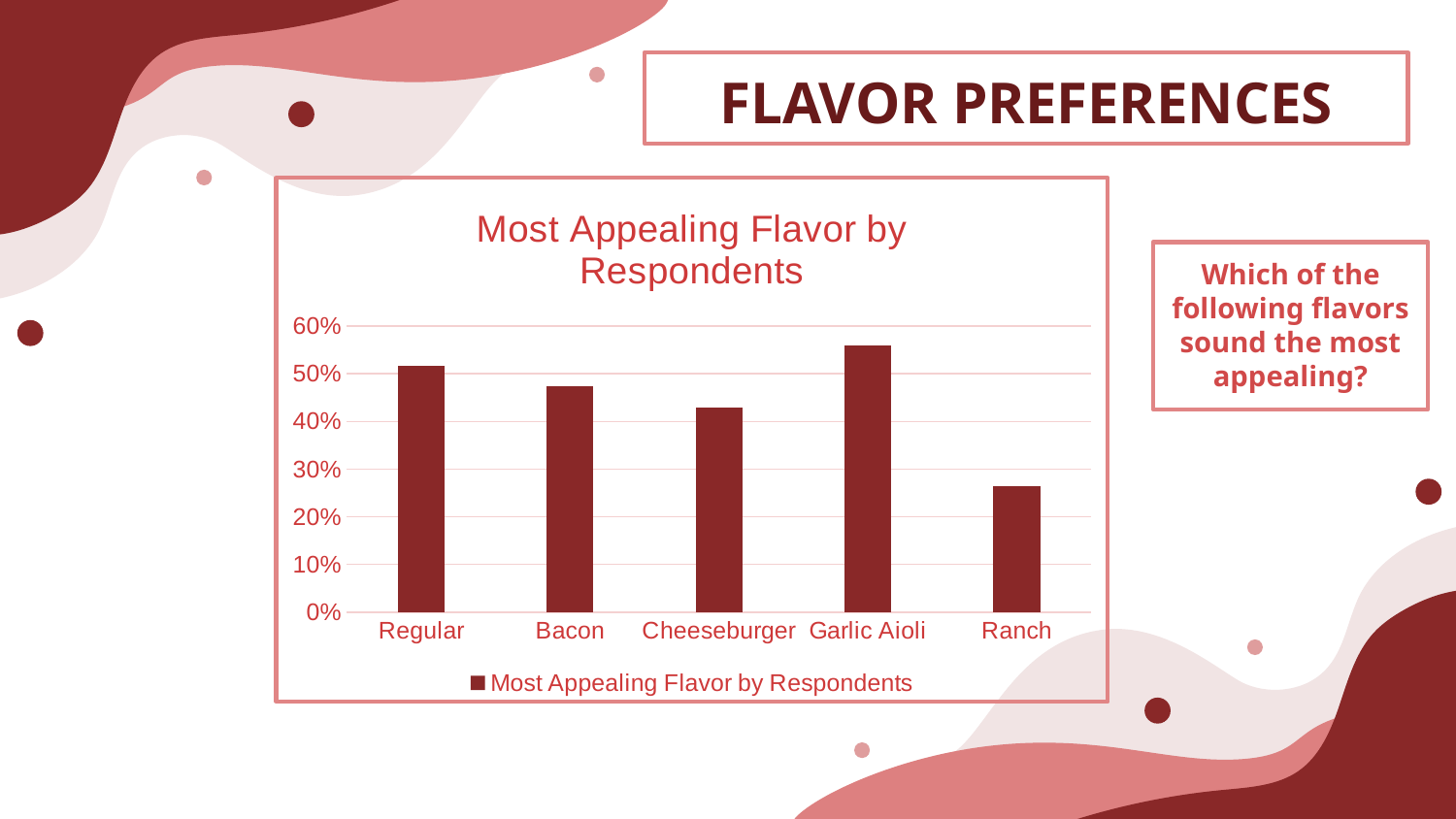
What kind of chart is shown on the slide? bar chart Which is larger, the value for Cheeseburger or the value for Ranch? Cheeseburger Is the value for Bacon greater or less than 50%? less Which is larger, the value for Garlic Aioli or the value for Regular? Garlic Aioli Is the value for Ranch greater or less than 30%? less How many series does the chart's legend list? 1 How many flavors are shown on the x axis of the chart? 5 Which flavor has the highest value in the chart? Garlic Aioli What is the title of the chart? Most Appealing Flavor by Respondents Is the value for Garlic Aioli greater or less than 50%? greater Which flavor has the lowest value in the chart? Ranch